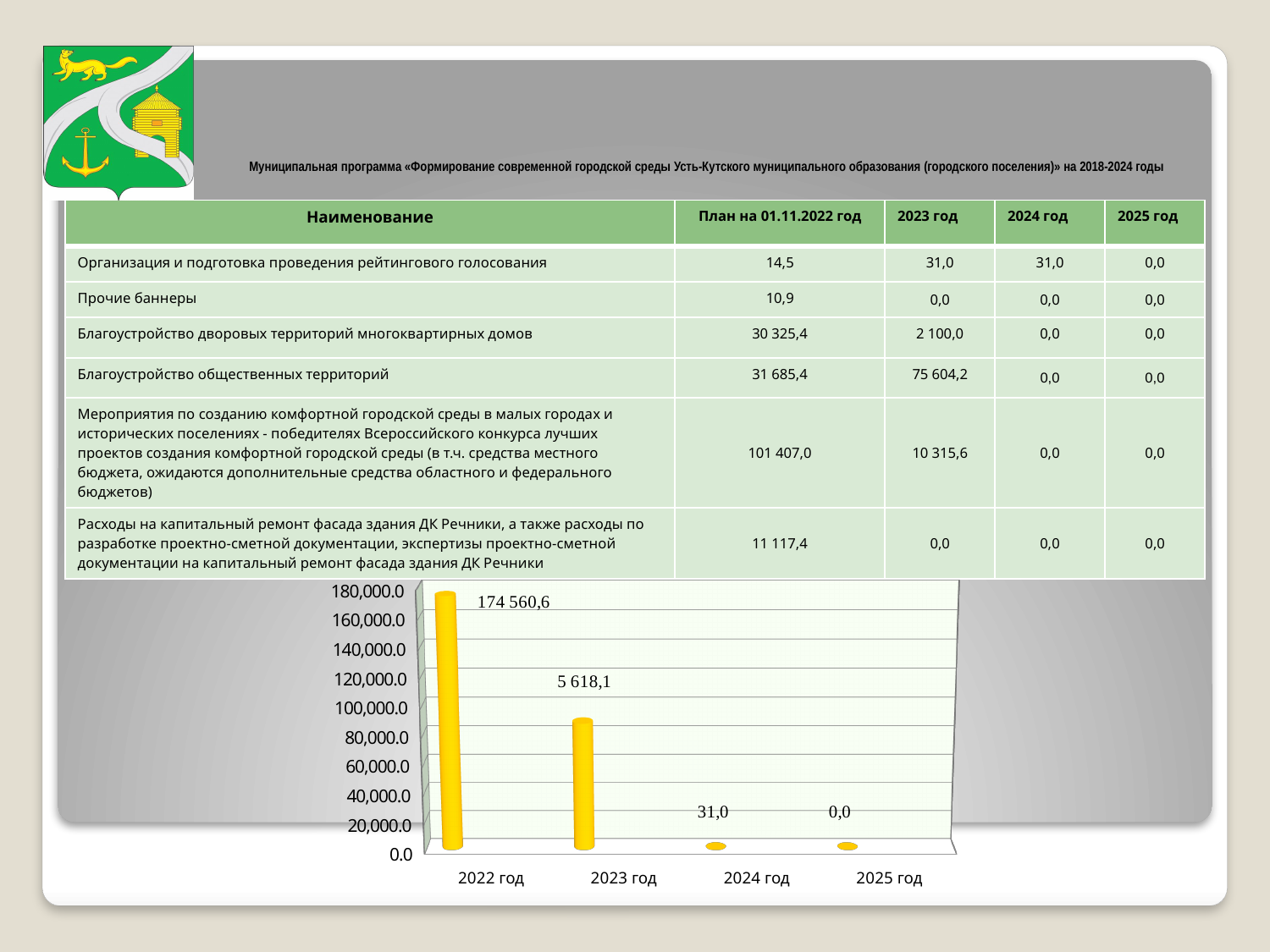
How many years (categories) are shown on the x axis of the bar chart? 4 Which is larger in the bar chart, the value for 2022 год or the value for 2024 год? 2022 год What is the value shown for 2025 год in the bar chart? 0,0 What kind of chart is shown at the bottom of the slide? bar chart Is the value for 2022 год in the bar chart greater or less than 160,000? greater What is the value shown for 2024 год in the bar chart? 31,0 What is the value shown for 2022 год in the bar chart? 174 560,6 What is the difference between the values for 2024 год and 2025 год in the bar chart? 31,0 Which year has the lowest value in the bar chart? 2025 год What is the highest tick value shown on the vertical axis of the bar chart? 180,000.0 Do the values in the bar chart rise or fall from 2022 год to 2025 год? fall Which year has the highest value in the bar chart? 2022 год